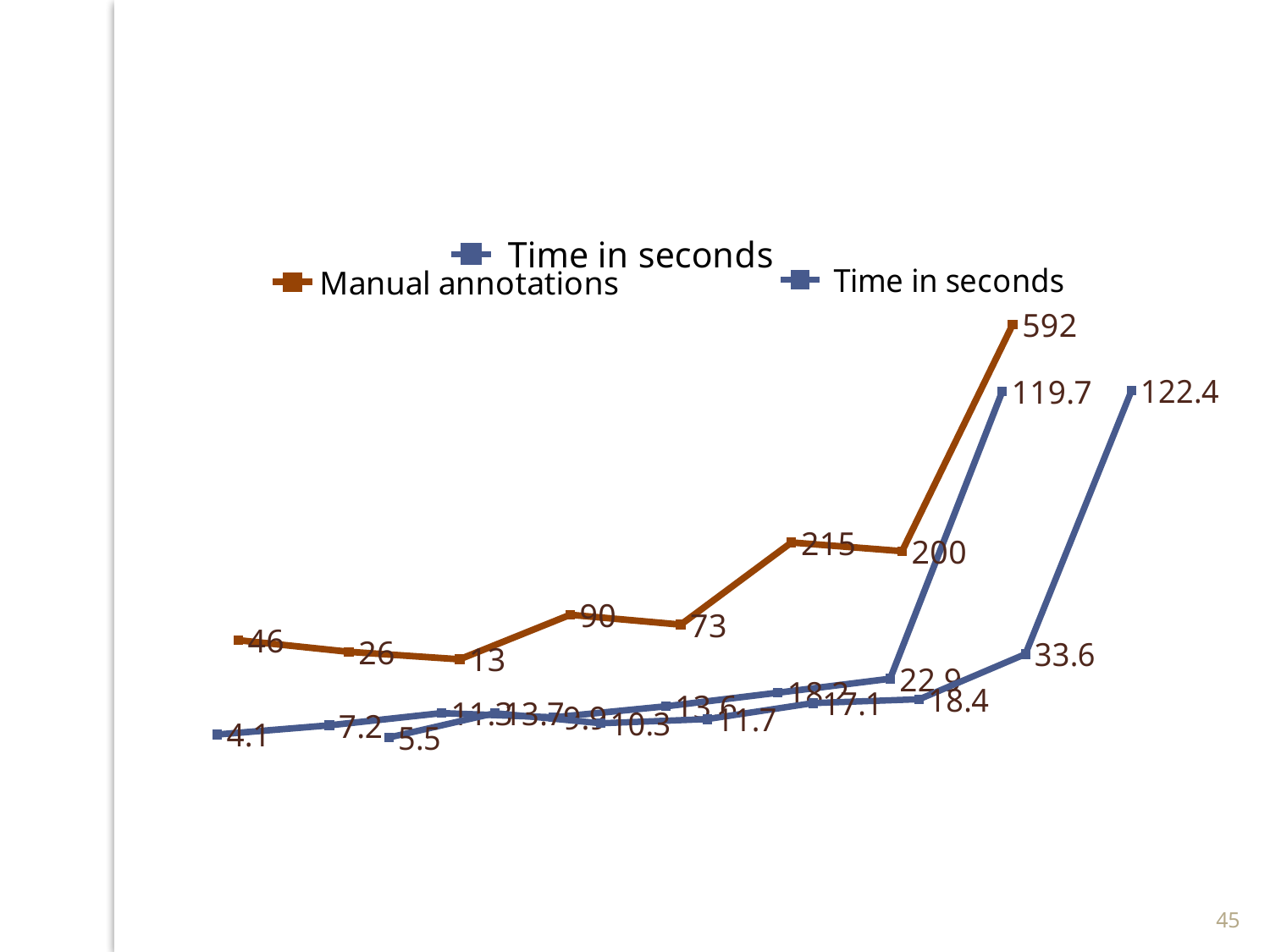
What is the difference between the Manual annotations values labelled 215 and 200? 15 Which series reaches a higher final value, Manual annotations (592) or the Time in seconds line ending at 119.7? Manual annotations What kind of chart is shown on the slide? line chart How many data points are plotted on the Manual annotations line? 8 Overall, do the values on the Manual annotations line rise or fall from the first point to the last point? rise What is the difference between the highest and lowest labelled values on the Manual annotations line? 579 What is the lowest value labelled on the Manual annotations line? 13 What is the highest value labelled on the Manual annotations line? 592